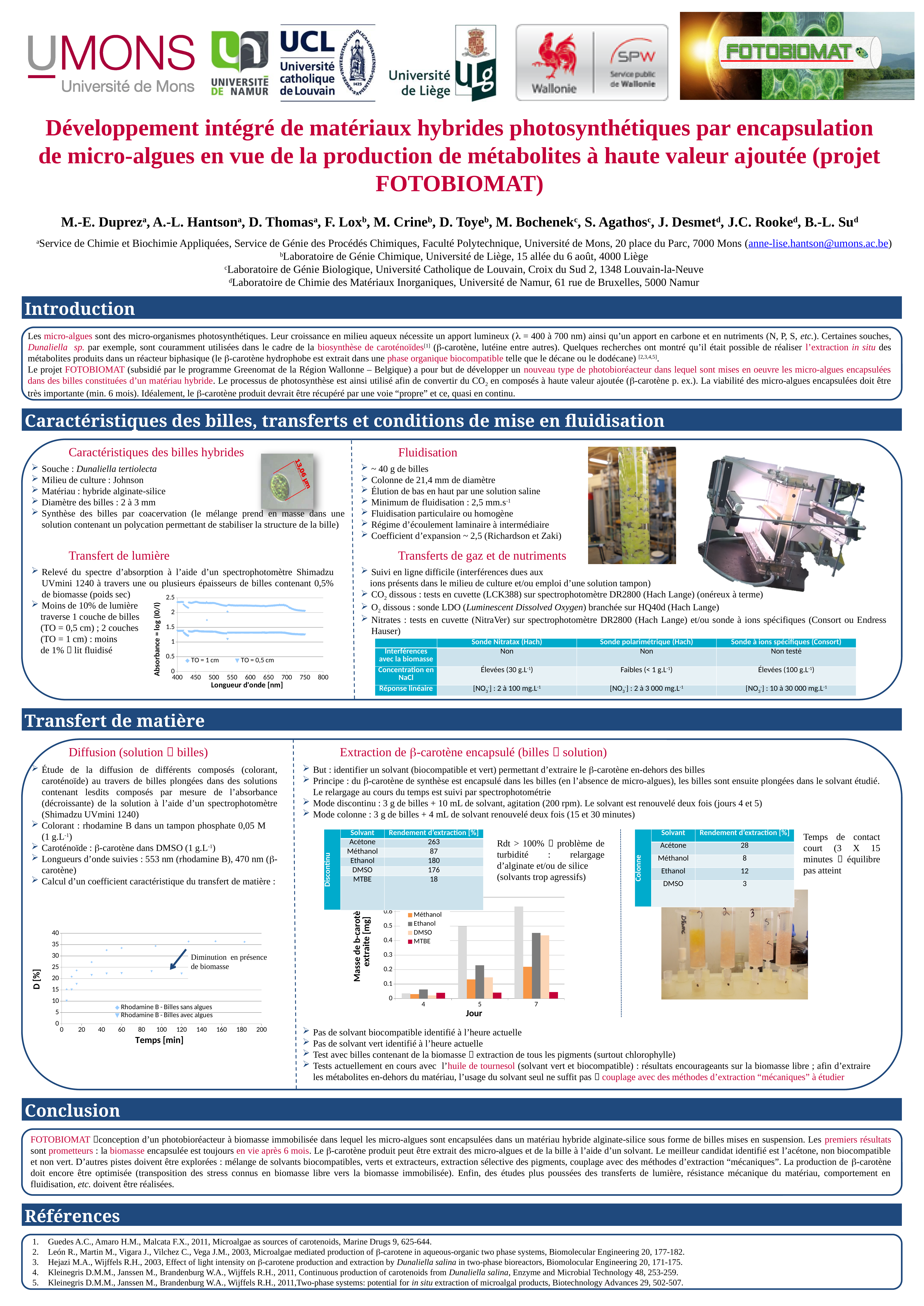
In the absorbance versus wavelength chart (Transfert de lumière section), how many series does the legend list? 2 In the D [%] versus Temps [min] chart, is the value for Rhodamine B - Billes sans algues at 180 min greater or less than 30? greater What kind of chart is the 'Masse de b-carotène extraite [mg]' versus 'Jour' chart? bar chart In the 'Masse de b-carotène extraite [mg]' bar chart, how many day categories are shown on the x axis? 3 In the absorbance versus wavelength chart, is the absorbance for TO = 1 cm at 450 nm greater or less than 2? greater In the D [%] versus Temps [min] chart (Diffusion section), how many series does the legend list? 2 In the D [%] versus Temps [min] chart, do the values for Rhodamine B - Billes sans algues rise or fall as time increases? rise In the 'Masse de b-carotène extraite [mg]' bar chart, is the value for Ethanol on day 7 greater or less than 0.4? greater In the absorbance versus wavelength chart, what is the label of the x axis? Longueur d'onde [nm] In the absorbance versus wavelength chart, which series shows the higher absorbance values, TO = 1 cm or TO = 0,5 cm? TO = 1 cm In the D [%] versus Temps [min] chart, which series reaches higher D values, Billes sans algues or Billes avec algues? Rhodamine B - Billes sans algues